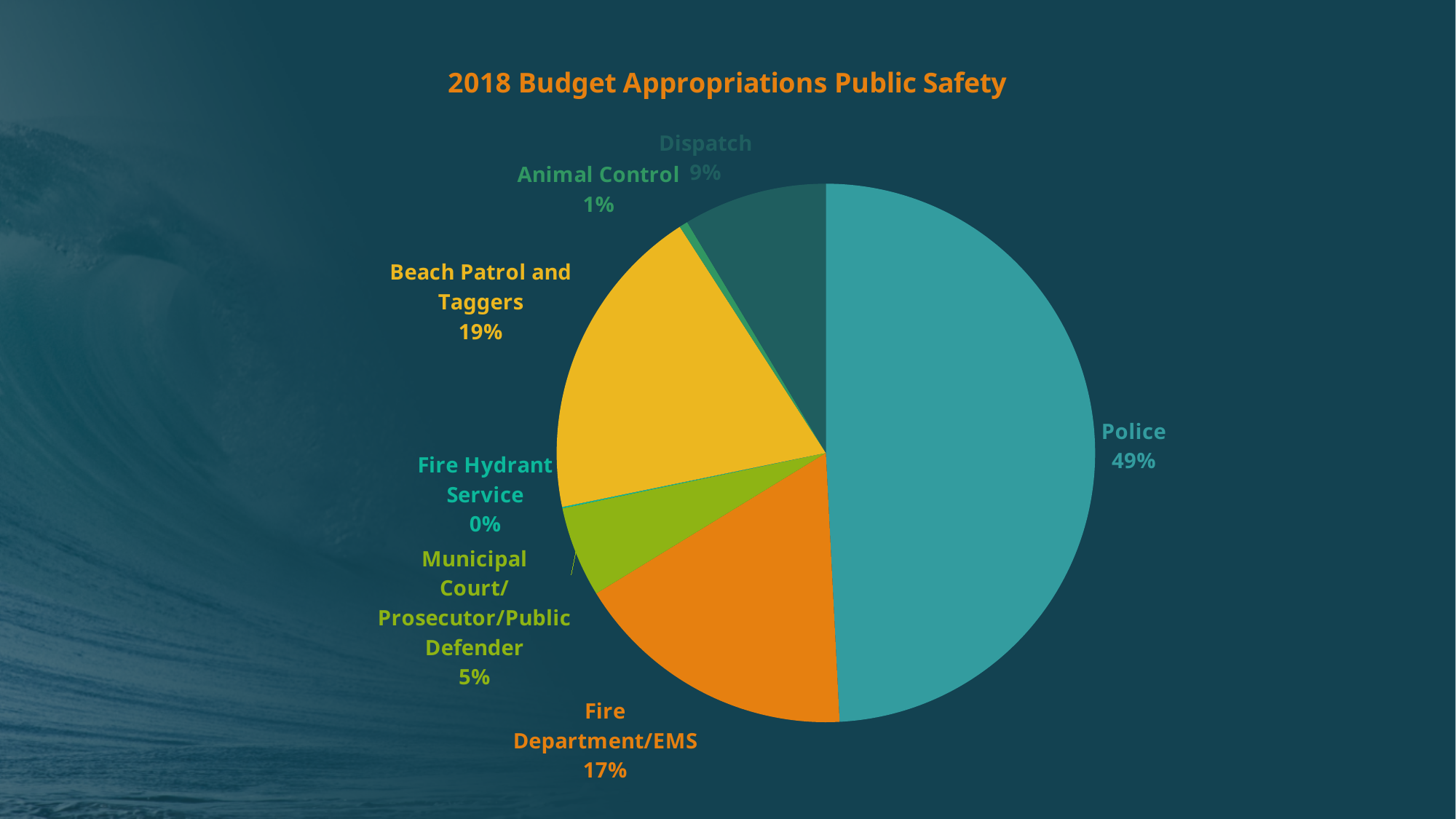
What share of the pie does Police account for? 49% What percentage is shown for Animal Control? 1% What kind of chart is shown on the slide? pie chart What is the difference in percentage points between Police and Fire Department/EMS? 32 Which category has the largest share of the pie? Police Which is larger, the share for Beach Patrol and Taggers or the share for Dispatch? Beach Patrol and Taggers Which category has the smallest share of the pie? Fire Hydrant Service What percentage is shown for Dispatch? 9% What percentage is shown for Fire Department/EMS? 17% What percentage is shown for Municipal Court/Prosecutor/Public Defender? 5% What is the title of the chart? 2018 Budget Appropriations Public Safety What percentage is shown for Beach Patrol and Taggers? 19%